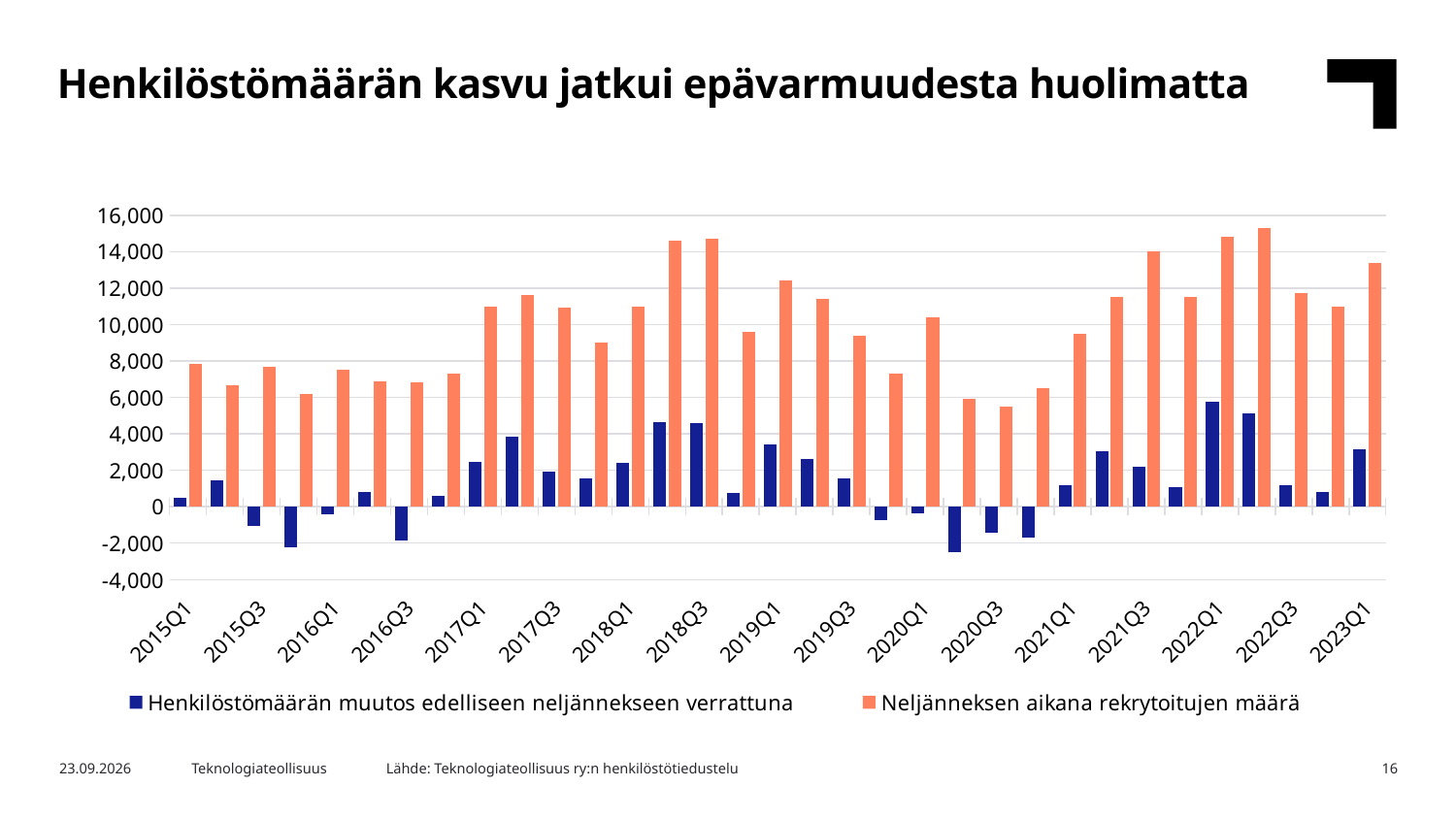
How many quarters are plotted on the x axis, from 2015Q1 to 2023Q1? 33 Is the value of 'Neljänneksen aikana rekrytoitujen määrä' for 2020Q3 greater or less than 6,000? less What type of chart is shown on the slide? Bar chart How many series does the legend list? 2 Which is larger for 'Neljänneksen aikana rekrytoitujen määrä': 2018Q3 or 2015Q1? 2018Q3 Which quarter has the highest value for 'Henkilöstömäärän muutos edelliseen neljännekseen verrattuna'? 2022Q1 Is the value of 'Henkilöstömäärän muutos edelliseen neljännekseen verrattuna' for 2016Q3 greater or less than 0? less Which series is shown in orange according to the legend? Neljänneksen aikana rekrytoitujen määrä Which quarter has the lowest value for 'Neljänneksen aikana rekrytoitujen määrä'? 2020Q3 What is the title of the slide? Henkilöstömäärän kasvu jatkui epävarmuudesta huolimatta Is the value of 'Henkilöstömäärän muutos edelliseen neljännekseen verrattuna' for 2022Q1 greater or less than 4,000? greater